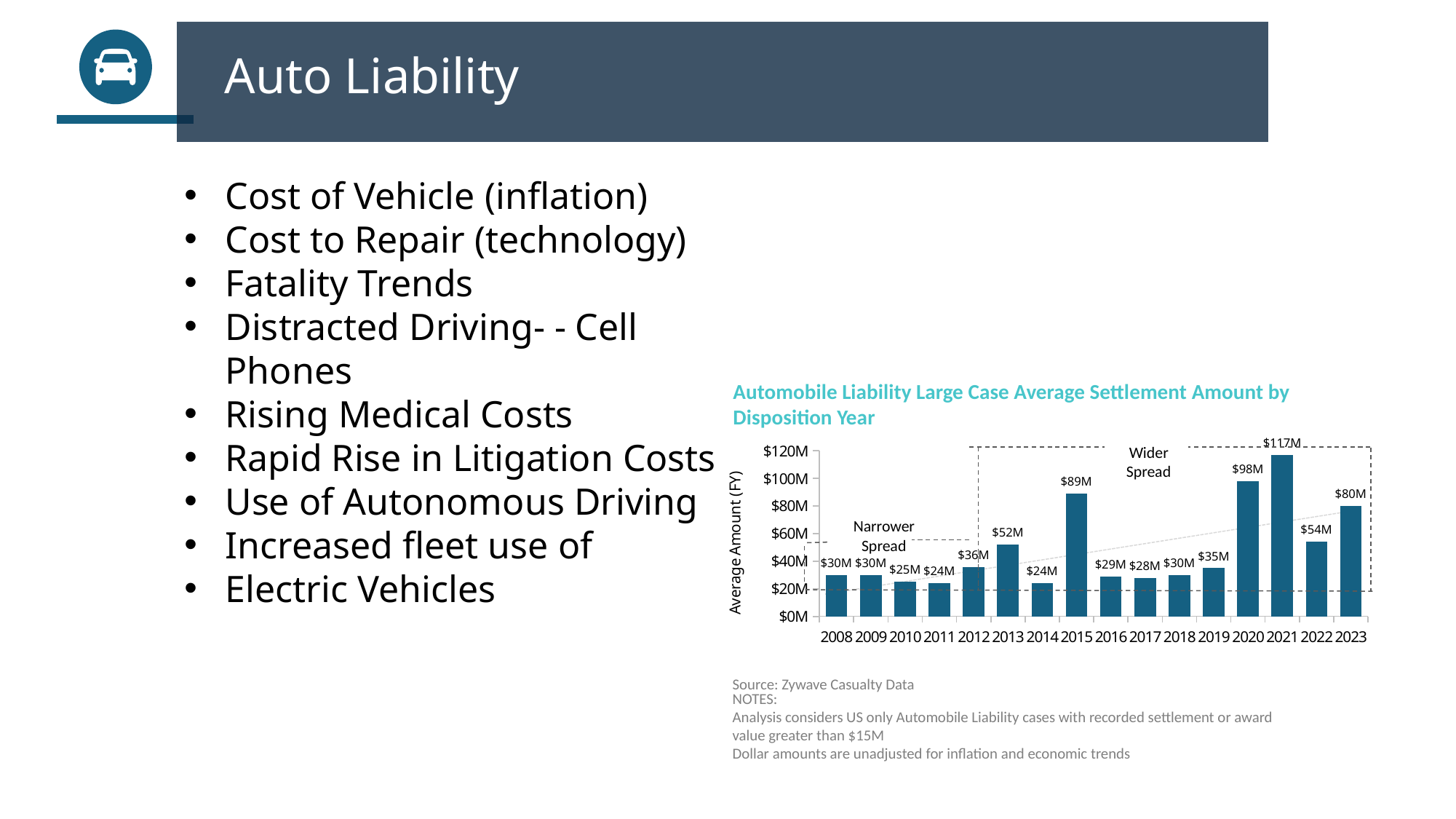
What is the title of the chart? Automobile Liability Large Case Average Settlement Amount by Disposition Year What is the label on the y axis of the chart? Average Amount (FY) Which year has the highest average settlement amount? 2021 What kind of chart is shown on the slide? bar chart How many years are shown on the x axis of the chart? 16 Is the average settlement amount for 2020 greater or less than $80M? greater What is the difference between the average settlement amounts for 2021 and 2020? $19M Which year has a larger average settlement amount, 2013 or 2022? 2022 What is the average settlement amount for 2015? $89M What is the average settlement amount for 2023? $80M What is the average settlement amount for 2021? $117M What is the difference between the average settlement amounts for 2023 and 2022? $26M